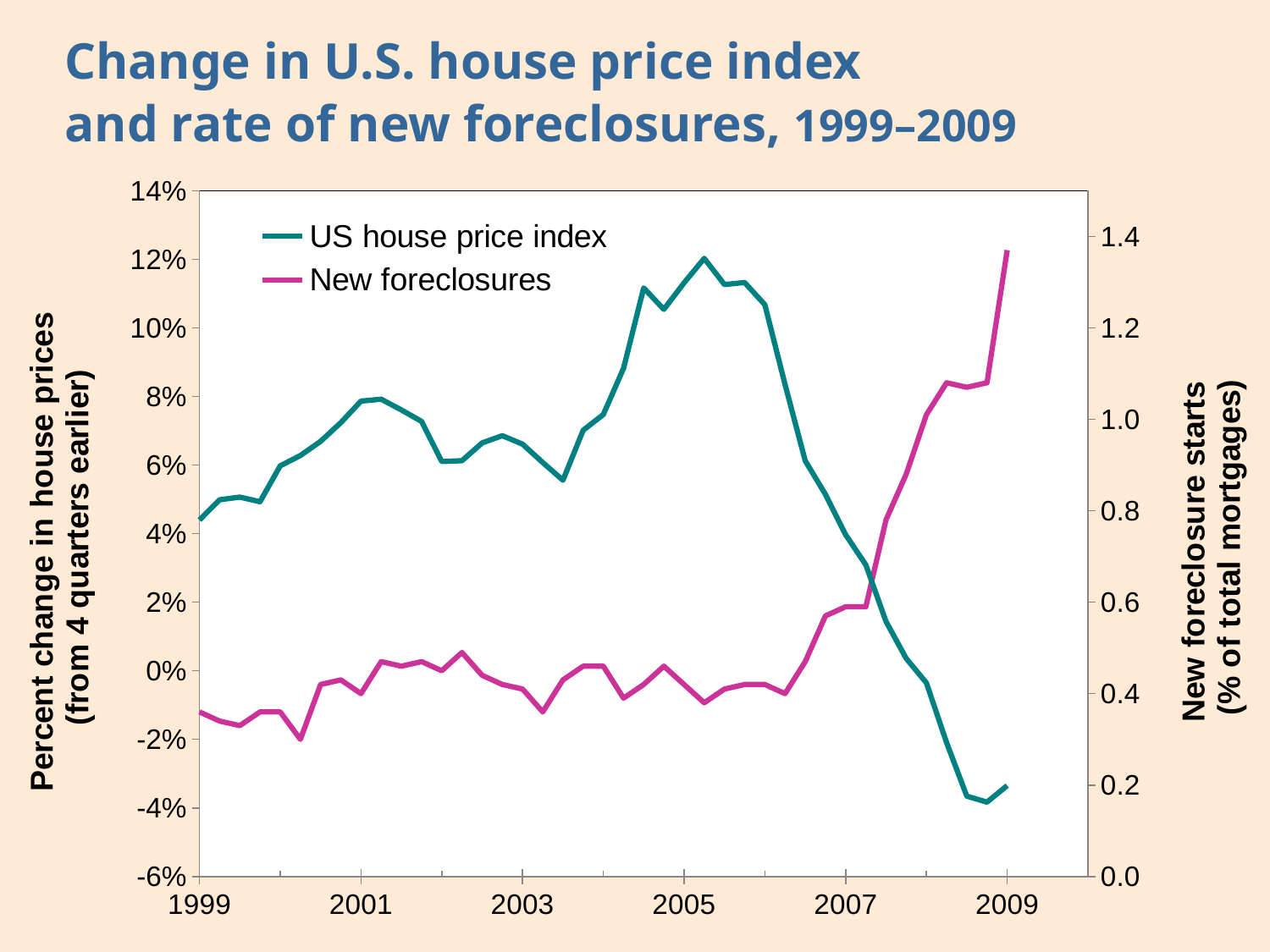
Is the value of New foreclosures at 2009 greater or less than 1.2? greater Is the value of the US house price index at 2005 greater or less than 10%? greater What are the two series named in the legend? US house price index and New foreclosures Which is larger for the US house price index: the value at 2005 or the value at 2009? 2005 What kind of chart is shown on the slide? line chart What is the title of the chart? Change in U.S. house price index and rate of new foreclosures, 1999–2009 Is the value of New foreclosures at 1999 greater or less than 0.4? less Do New foreclosures rise or fall between 2007 and 2009? rise How many series does the legend list? 2 Does the US house price index rise or fall between 2006 and 2009? fall